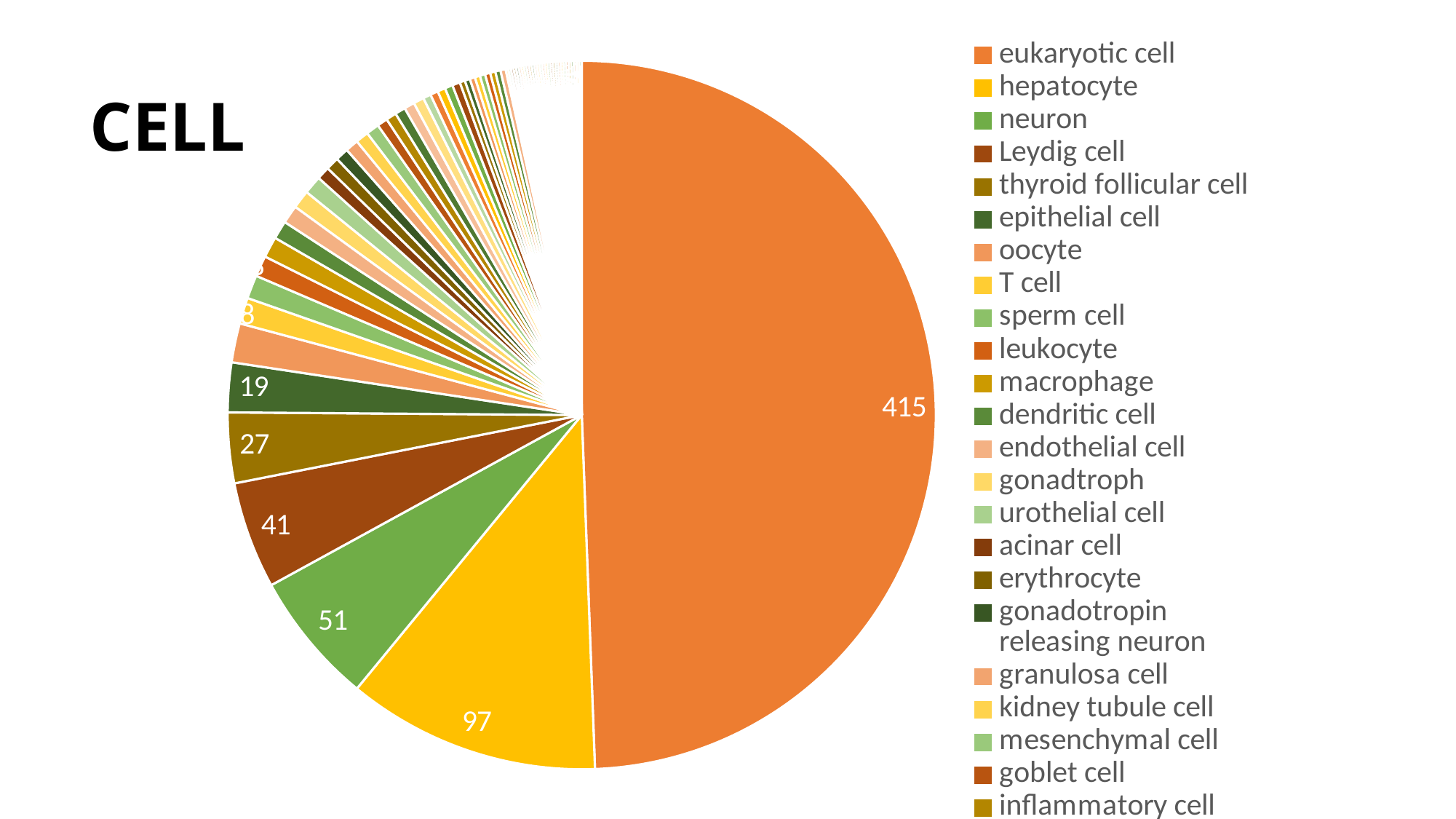
What is the value for Leydig cell? 41 Which is larger, the value for neuron or the value for Leydig cell? neuron What kind of chart is shown on the slide? pie chart What is the title of the chart? CELL What is the value for thyroid follicular cell? 27 What is the difference between the values for eukaryotic cell and hepatocyte? 318 What is the value for neuron? 51 What is the value for eukaryotic cell? 415 Which category has the largest slice of the pie? eukaryotic cell What is the difference between the values for hepatocyte and neuron? 46 What is the value for hepatocyte? 97 What is the value for epithelial cell? 19